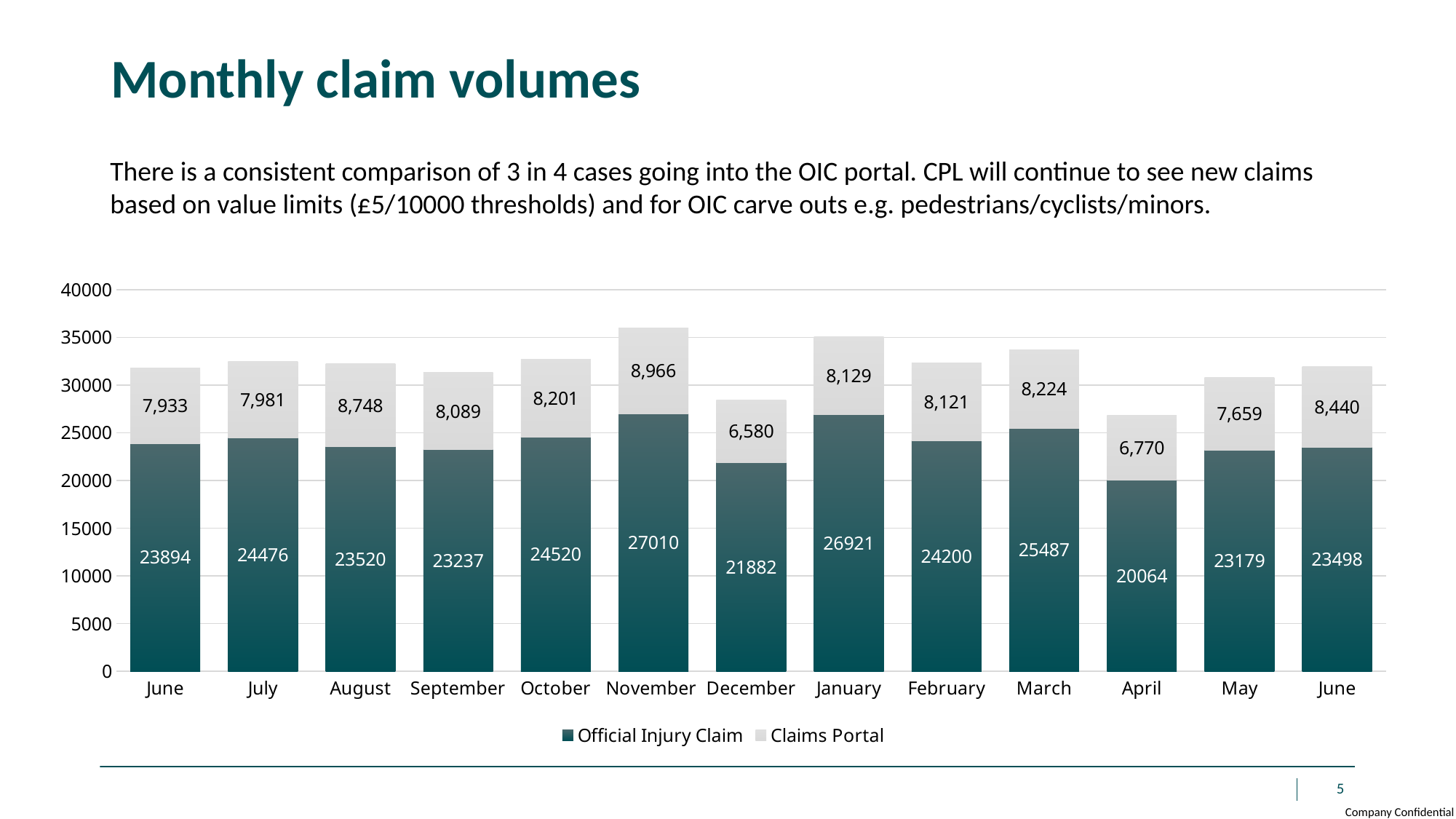
What is the difference between the Official Injury Claim values for November and December? 5128 Is the total stacked bar for November greater or less than 35000? greater Which month has the highest Official Injury Claim value? November How many months are shown on the x axis? 13 What is the Claims Portal value for December? 6,580 What is the Official Injury Claim value for November? 27010 Which is larger, the Official Injury Claim value for January or for March? January What kind of chart is shown on the slide? Stacked bar chart Which month has the lowest Claims Portal value? December What is the total of the stacked bar for April? 26834 How many series does the legend list? 2 What is the Official Injury Claim value for April? 20064